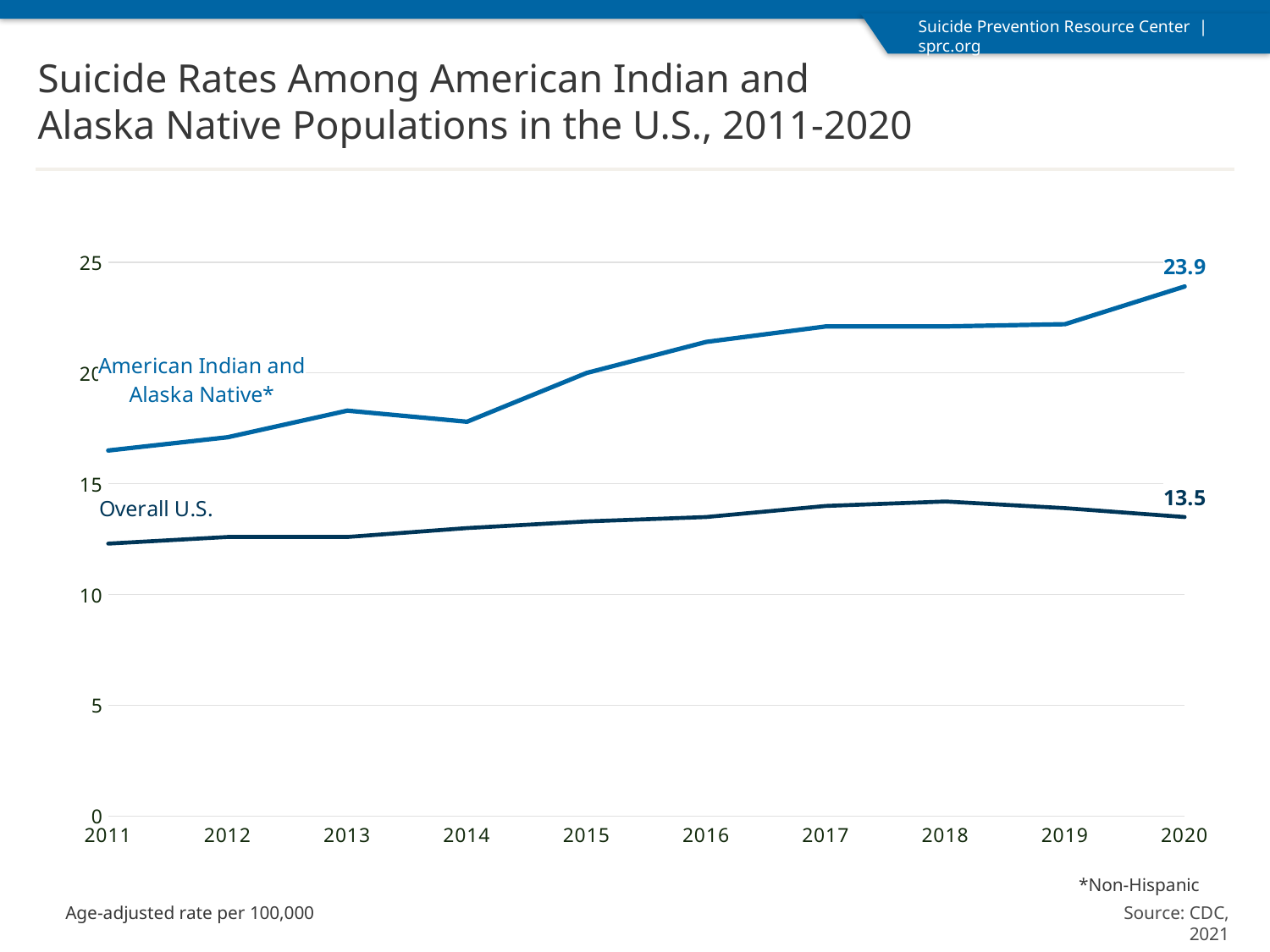
Is the Overall U.S. rate in 2011 greater or less than 15? less What unit is the rate measured in, according to the note at the bottom of the chart? Age-adjusted rate per 100,000 Is the American Indian and Alaska Native rate in 2017 greater or less than 20? greater What is the Overall U.S. suicide rate in 2020? 13.5 In 2020, which is higher: the American Indian and Alaska Native rate or the Overall U.S. rate? American Indian and Alaska Native What is the difference between the American Indian and Alaska Native rate and the Overall U.S. rate in 2020? 10.4 Is the American Indian and Alaska Native rate in 2011 greater or less than 20? less What is the suicide rate for the American Indian and Alaska Native population in 2020? 23.9 What type of chart is shown on the slide? Line chart How many series are plotted on the chart? 2 In which year is the American Indian and Alaska Native rate highest? 2020 How many years are shown on the x axis of the chart? 10